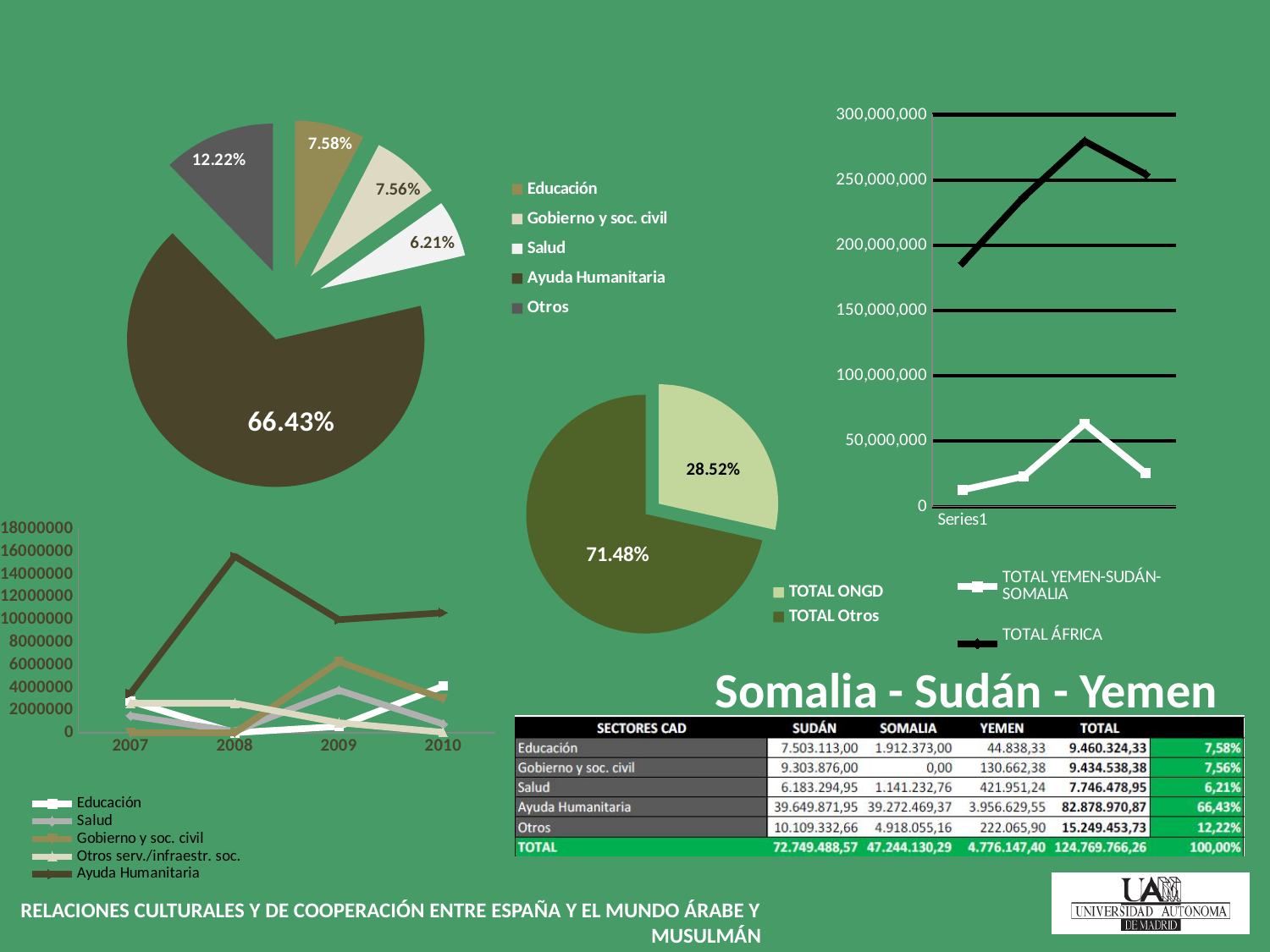
How many categories does the legend of the large pie chart at the top left list? 5 In the large pie chart at the top left, what share does the largest slice (Ayuda Humanitaria) have? 66.43% In the large pie chart at the top left, which category has the smallest slice? Salud In the large pie chart at the top left, what percentage is shown for the Otros slice? 12.22% In the large pie chart at the top left, what is the difference between the Educación slice (7.58%) and the Salud slice (6.21%)? 1.37% In the line chart at the top right, is the highest value of the TOTAL YEMEN-SUDÁN-SOMALIA series greater or less than 100,000,000? less What kind of chart is the chart at the top right of the slide with the TOTAL ÁFRICA and TOTAL YEMEN-SUDÁN-SOMALIA series? line chart In the small pie chart in the centre of the slide, which slice is larger, TOTAL ONGD or TOTAL Otros? TOTAL Otros How many series does the legend of the line chart at the bottom left (years 2007 to 2010) list? 5 In the small pie chart in the centre of the slide, what share does TOTAL ONGD have? 28.52% In the line chart at the bottom left, in which year does the Ayuda Humanitaria series reach its highest value? 2008 In the line chart at the top right, is the highest value of the TOTAL ÁFRICA series greater or less than 250,000,000? greater